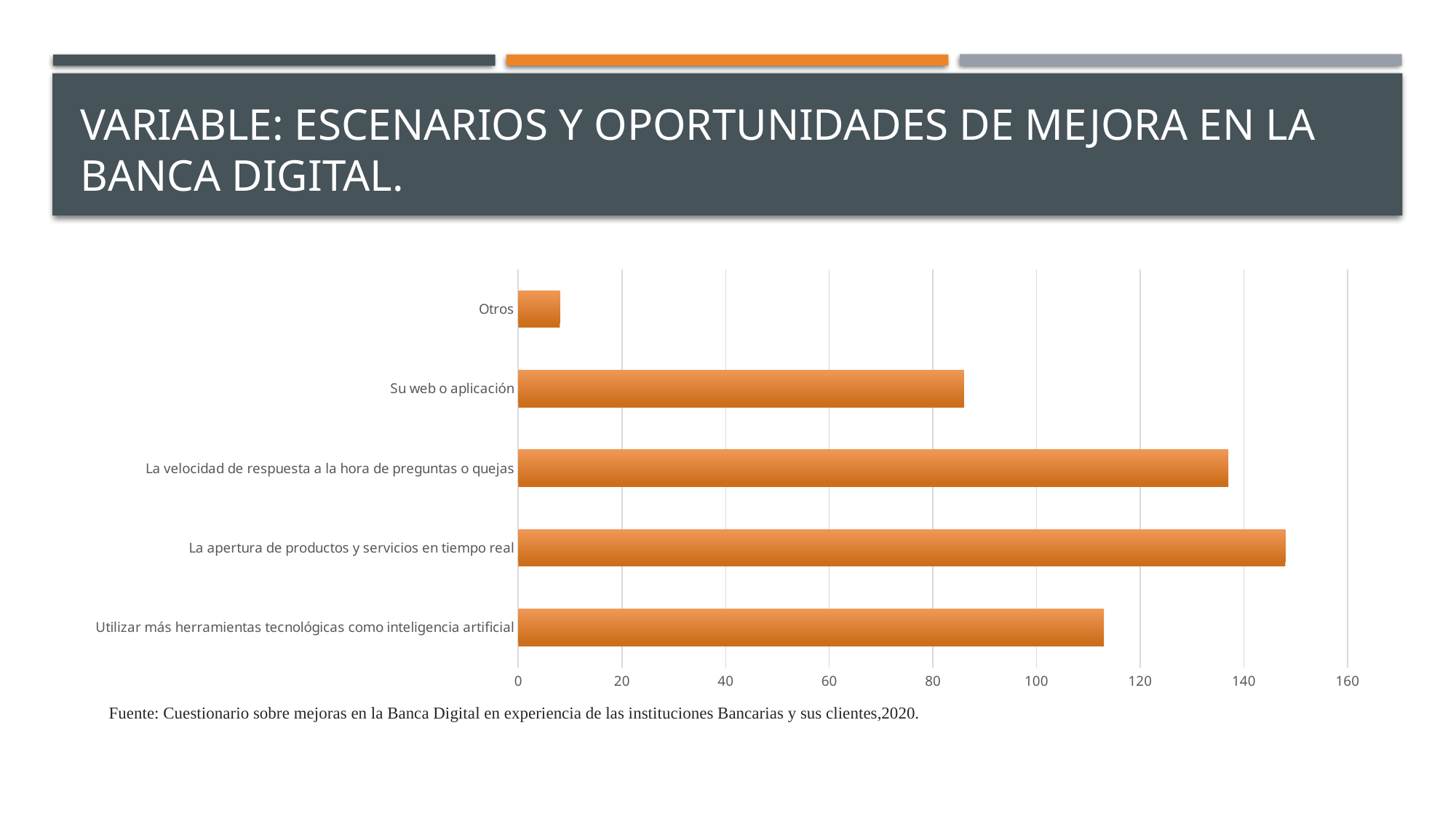
Is the value for Utilizar más herramientas tecnológicas como inteligencia artificial greater or less than 100? greater Is the value for Otros greater or less than 20? less Which is larger: the value for Su web o aplicación or the value for Utilizar más herramientas tecnológicas como inteligencia artificial? Utilizar más herramientas tecnológicas como inteligencia artificial Which is larger: the value for La velocidad de respuesta a la hora de preguntas o quejas or the value for Su web o aplicación? La velocidad de respuesta a la hora de preguntas o quejas Which category has the highest value in the chart? La apertura de productos y servicios en tiempo real What is the maximum value shown on the horizontal axis of the chart? 160 How many categories are plotted in the chart? 5 Is the value for La apertura de productos y servicios en tiempo real greater or less than 140? greater What kind of chart is shown on the slide? bar chart Which category has the lowest value in the chart? Otros